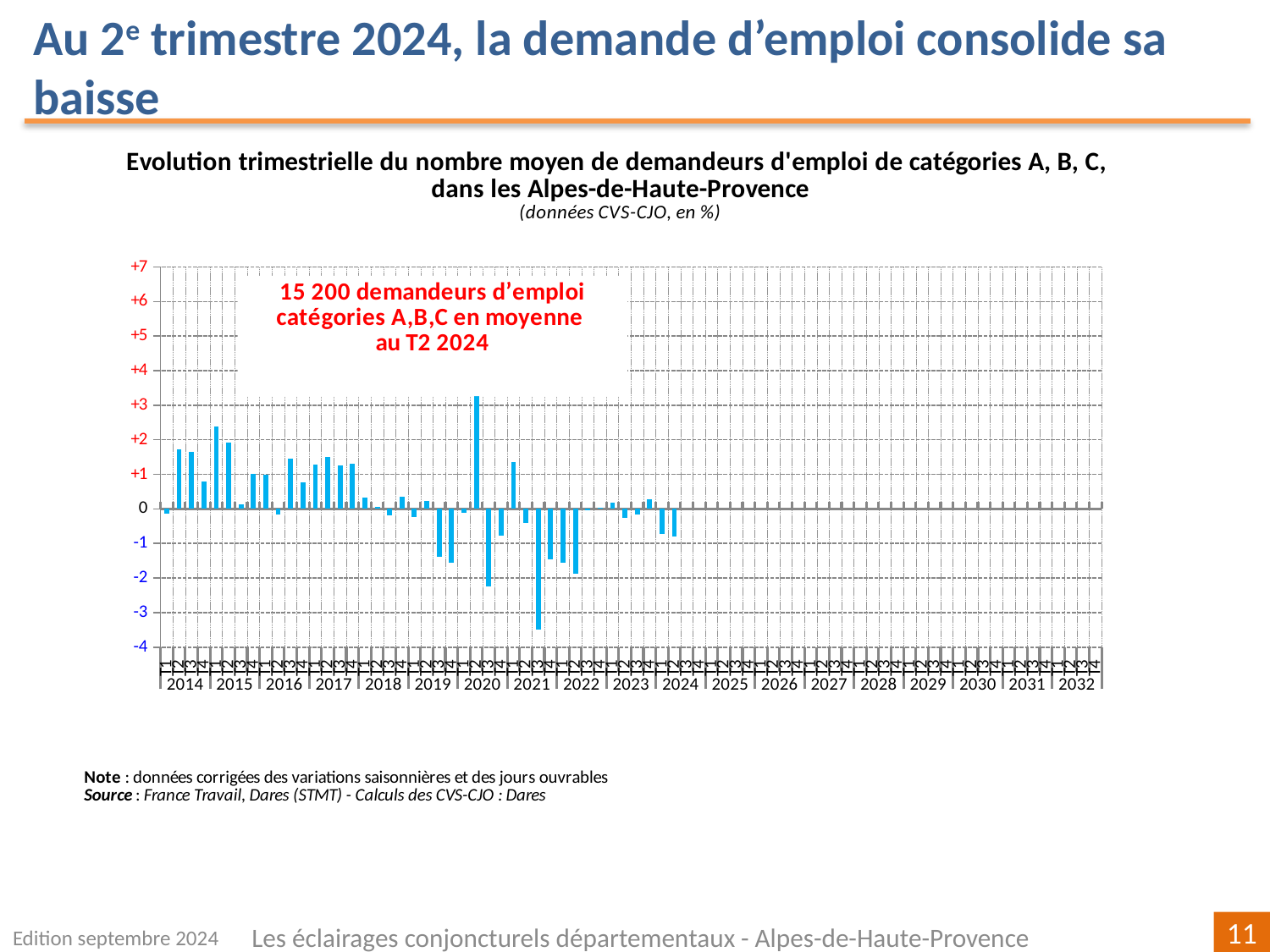
How many years are labelled on the x axis? 19 What kind of chart is shown on the slide? bar chart What is the highest value shown on the y axis? +7 Which year has the larger highest bar, 2015 or 2018? 2015 Is the highest bar on the chart greater or less than +3? greater Is the highest bar in 2015 greater or less than +2? greater Is the lowest bar on the chart greater or less than -3? less In which year does the chart show its highest bar? 2020 Are the bars in 2022 mostly positive or negative? negative What is the title of the chart? Evolution trimestrielle du nombre moyen de demandeurs d'emploi de catégories A, B, C, dans les Alpes-de-Haute-Provence According to the annotation on the chart, how many job seekers in categories A, B, C were there on average in T2 2024? 15 200 In which year does the chart show its lowest bar? 2021